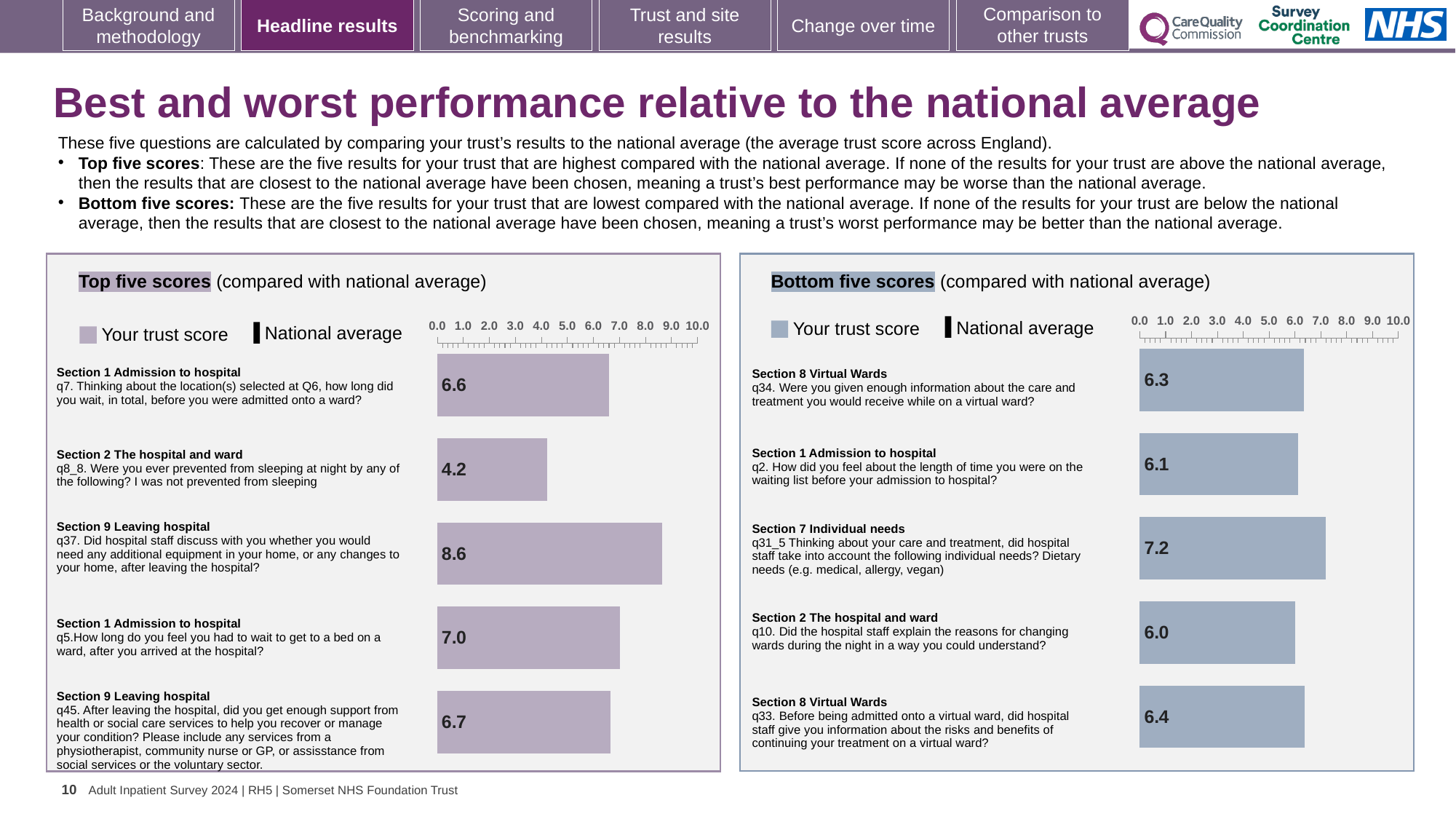
In the Top five scores chart, what is the trust score for q37 (Did hospital staff discuss with you whether you would need any additional equipment in your home)? 8.6 In the Top five scores chart, is the trust score for q8_8 greater or less than 5.0? less How many bars are shown in the Bottom five scores chart? 5 In the Bottom five scores chart, what is the trust score for q10 (Did the hospital staff explain the reasons for changing wards during the night)? 6.0 In the Top five scores chart, which question has the lowest trust score? q8_8 (Section 2 The hospital and ward) In the Bottom five scores chart, what is the difference between the trust scores for q31_5 and q2? 1.1 In the Top five scores chart, which has the larger trust score: q5 or q45? q5 In the Top five scores chart, what is the difference between the trust scores for q37 and q8_8? 4.4 What type of chart is used in the Top five scores panel? Bar chart In the Bottom five scores chart, which question has the lowest trust score? q10 (Section 2 The hospital and ward) In the Top five scores chart, which question has the highest trust score? q37 (Section 9 Leaving hospital) In the Bottom five scores chart, which question has the highest trust score? q31_5 (Section 7 Individual needs)